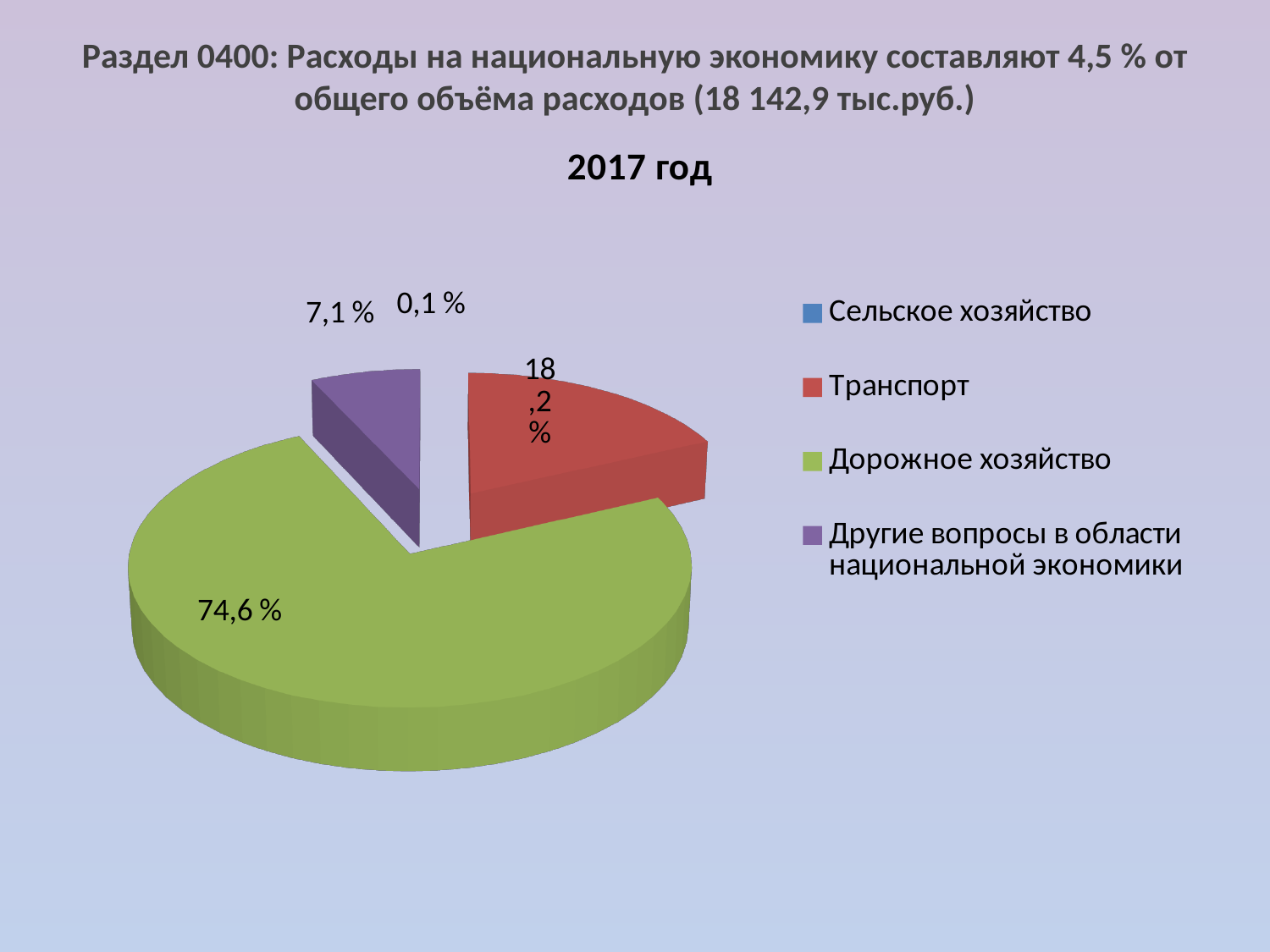
Which category has the smallest share of the pie? Сельское хозяйство What colour is the slice for Дорожное хозяйство? green What share of the pie does Дорожное хозяйство have? 74,6 % What type of chart is shown on the slide? pie chart Which category has the largest share of the pie? Дорожное хозяйство How many categories does the legend list? 4 Which is larger, the share for Транспорт or the share for Другие вопросы в области национальной экономики? Транспорт What year is shown above the chart? 2017 год What share of the pie does Сельское хозяйство have? 0,1 % What share of the pie does Другие вопросы в области национальной экономики have? 7,1 % What is the difference in percentage points between the shares of Дорожное хозяйство and Транспорт? 56,4 What share of the pie does Транспорт have? 18,2 %